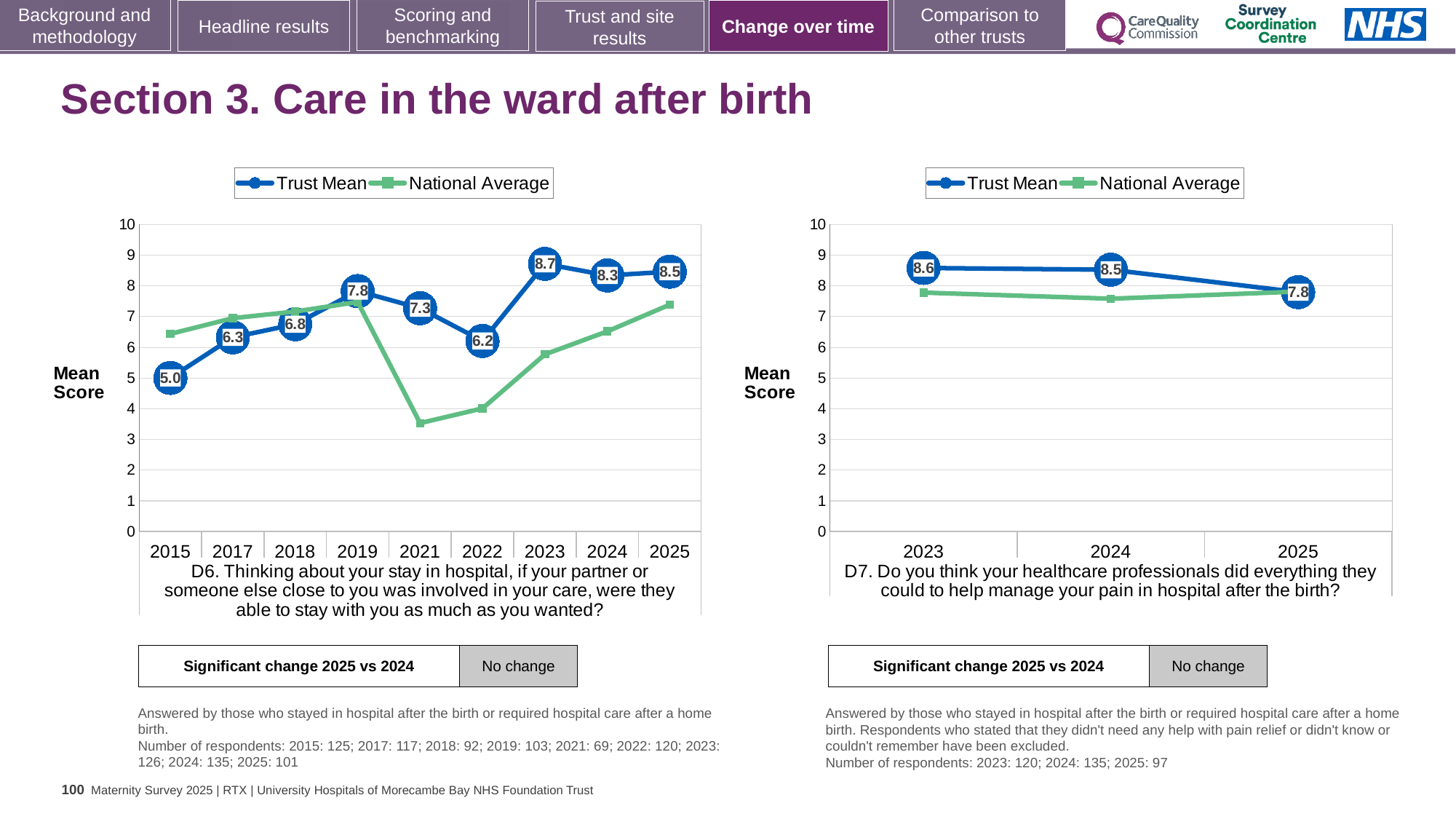
In the left chart (D6), which year has the lowest Trust Mean score? 2015 In the right chart (D7), what is the Trust Mean score for 2025? 7.8 In the left chart (D6), is the Trust Mean score for 2021 or 2022 larger? 2021 In the left chart (D6), what is the Trust Mean score for 2023? 8.7 In the left chart (D6), is the National Average for 2021 greater or less than 4? less In the left chart (D6), how many years are shown on the x axis? 9 What kind of chart is the right chart (D7)? line chart In the right chart (D7), does the Trust Mean rise or fall from 2023 to 2025? fall In the left chart (D6), what is the difference between the Trust Mean scores for 2025 and 2024? 0.2 In the right chart (D7), how many series does the legend list? 2 In the left chart (D6), what is the Trust Mean score for 2015? 5.0 In the left chart (D6), which year has the highest Trust Mean score? 2023